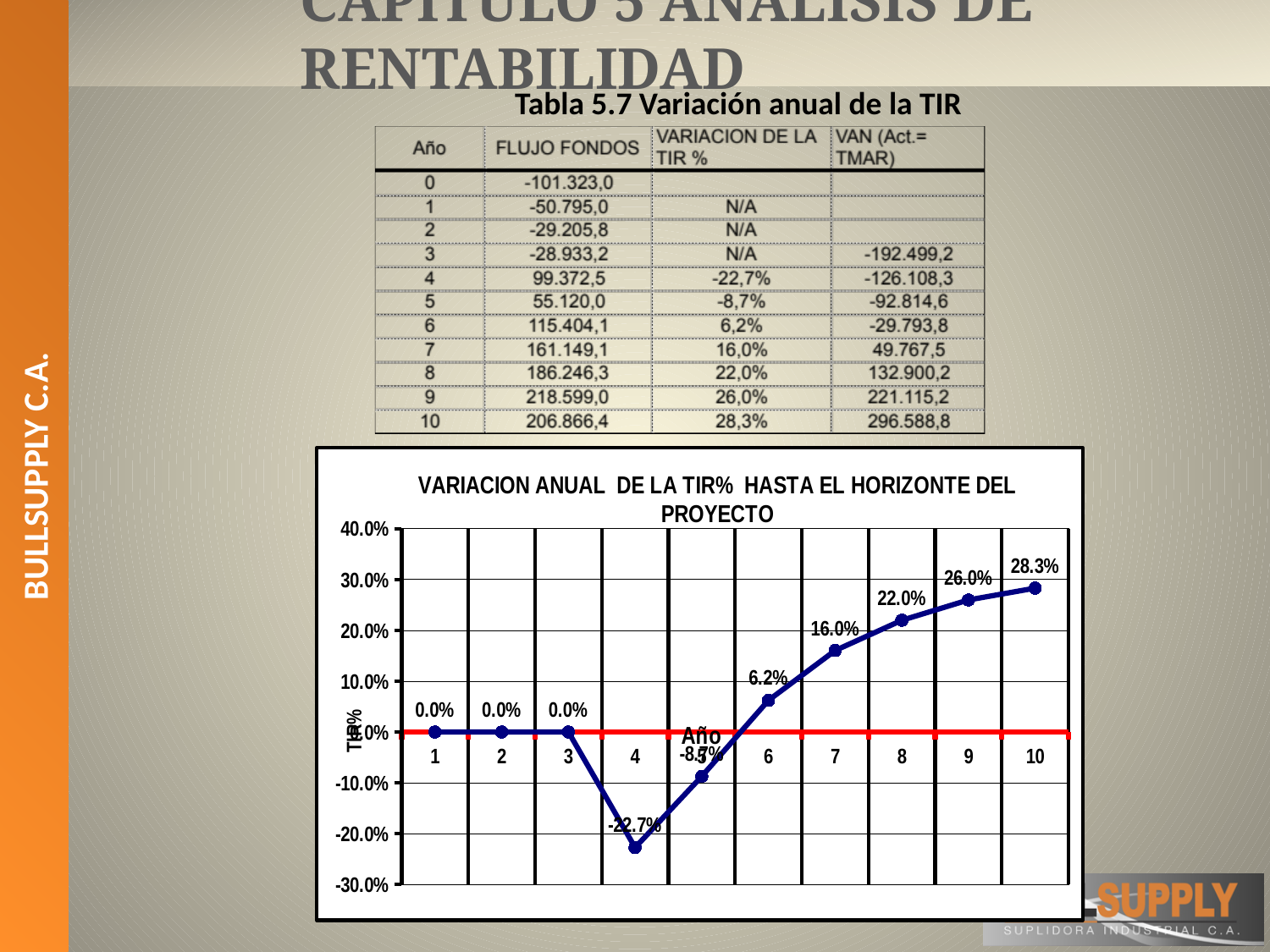
What is the difference between the TIR% values for year 9 and year 8? 4.0% Which year has the highest TIR% value in the chart? 10 What is the TIR% value for year 7 in the chart? 16.0% What is the TIR% value for year 10 in the chart? 28.3% Do the TIR% values rise or fall from year 4 to year 10? rise What is the TIR% value for year 4 in the chart? -22.7% How many years are plotted on the x axis of the chart? 10 Which year has the lowest TIR% value in the chart? 4 Is the TIR% value for year 8 greater or less than 20.0%? greater What type of chart is shown on the slide? line chart What is the title of the chart? VARIACION ANUAL DE LA TIR% HASTA EL HORIZONTE DEL PROYECTO Which is larger, the TIR% value for year 6 or for year 5? year 6